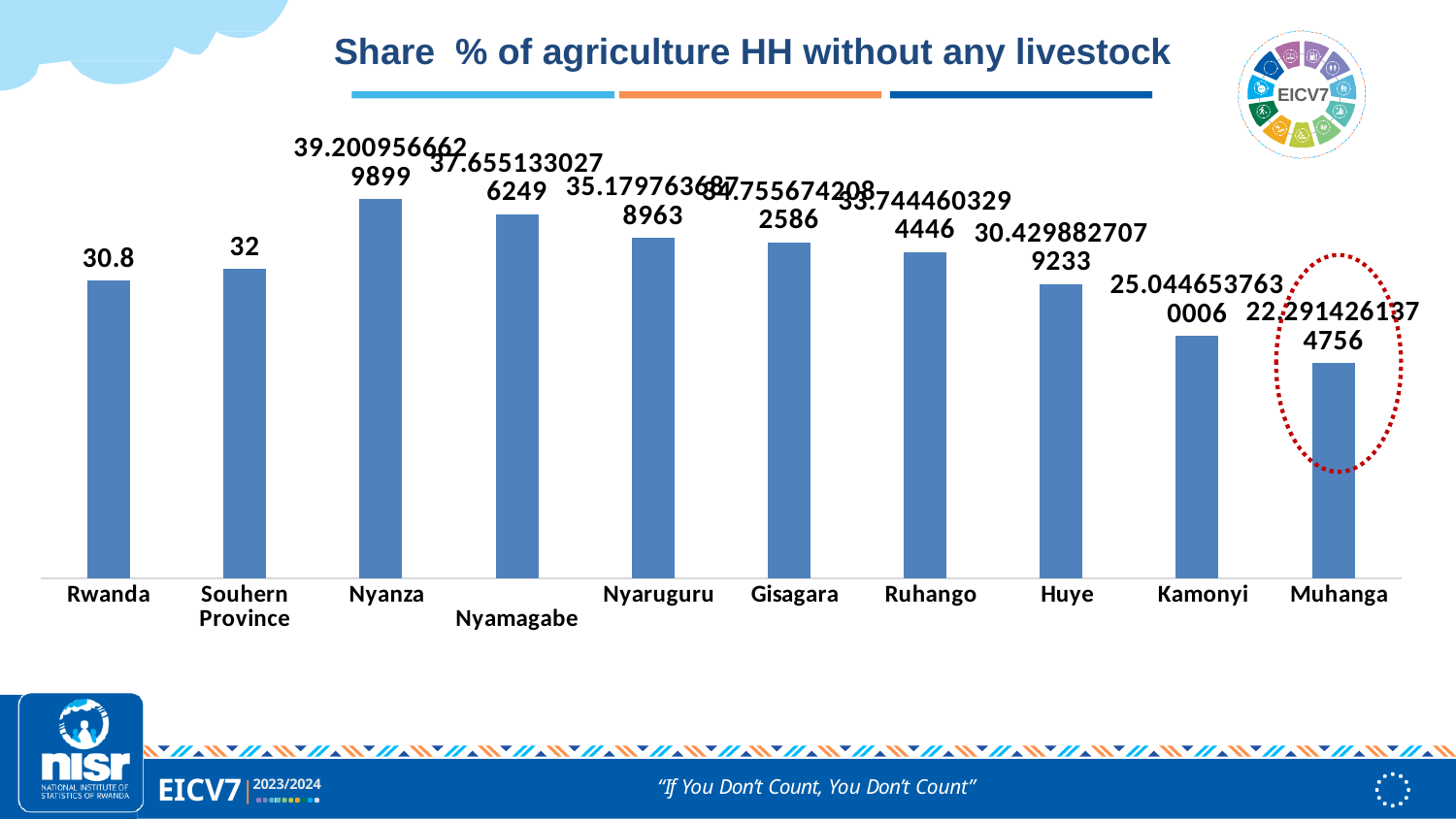
What is the title of the chart? Share % of agriculture HH without any livestock How many categories are shown on the x axis? 10 Which bar is highlighted with a red dotted circle? Muhanga Which category has the lowest value? Muhanga What is the difference between the values for Souhern Province and Rwanda? 1.2 From Nyanza to Muhanga, do the values rise or fall along the x axis? Fall What kind of chart is shown on the slide? Bar chart Which is larger, the value for Nyanza or the value for Muhanga? Nyanza What is the value for Rwanda? 30.8 Which is larger, the value for Kamonyi or the value for Huye? Huye Which category has the highest value? Nyanza What is the value for Souhern Province? 32